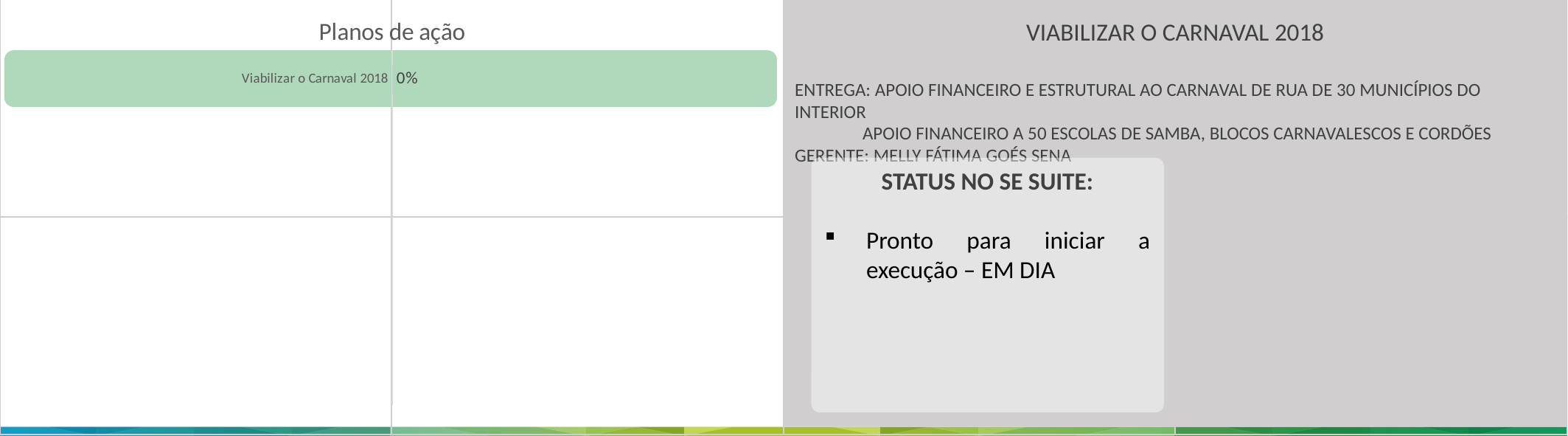
What kind of chart is the "Planos de ação" chart? bar chart How many categories does the "Planos de ação" chart show? 1 What is the title of the chart on the left side of the slide? Planos de ação What is the label of the only category in the "Planos de ação" chart? Viabilizar o Carnaval 2018 In the "Planos de ação" chart, what value is shown for "Viabilizar o Carnaval 2018"? 0%